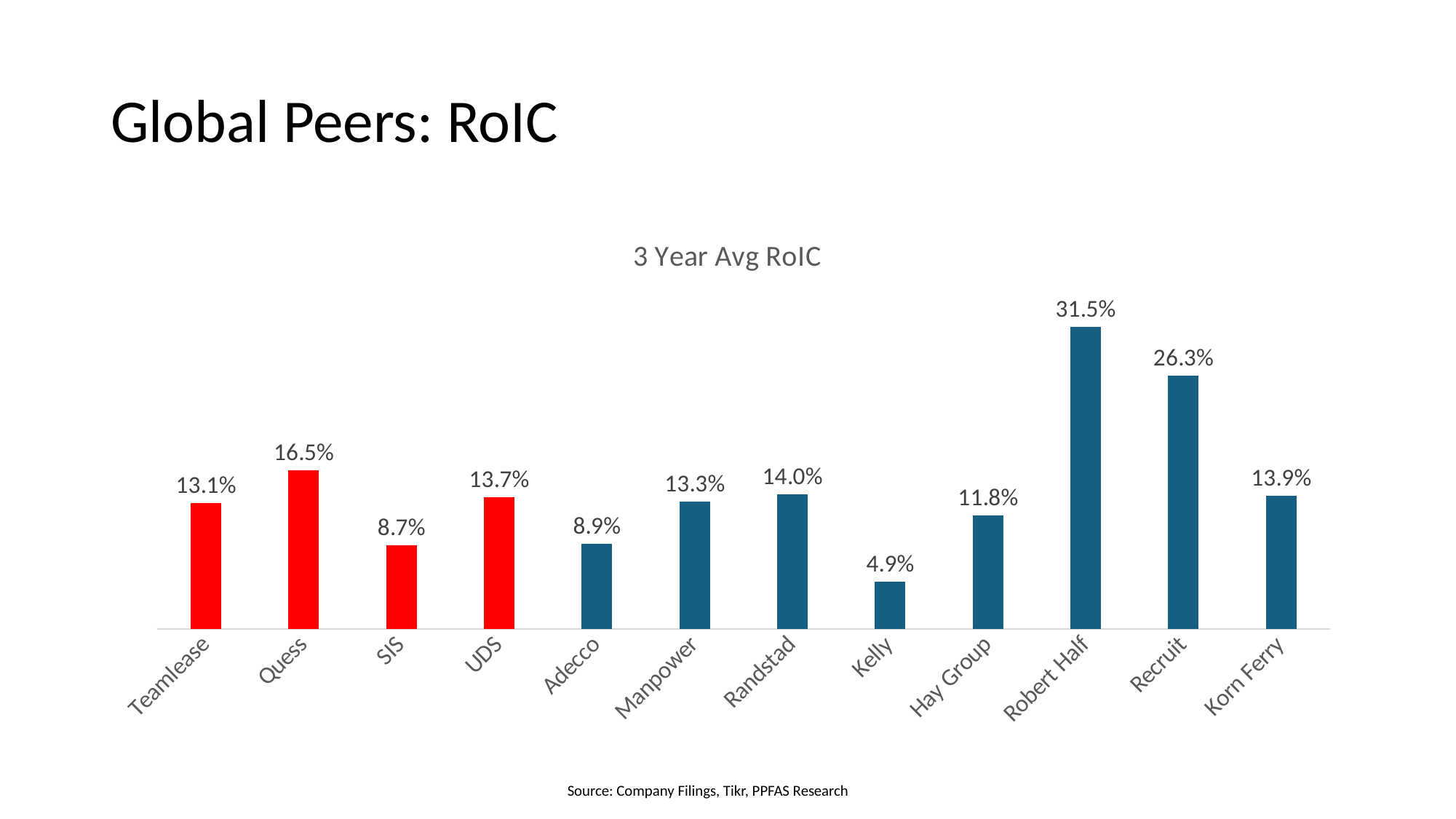
What is the title of the chart? 3 Year Avg RoIC Which company has the lowest 3 Year Avg RoIC? Kelly What is the 3 Year Avg RoIC for Quess? 16.5% How many companies are shown in the chart? 12 What is the difference in 3 Year Avg RoIC between Robert Half and Recruit? 5.2% Which has a higher 3 Year Avg RoIC, Randstad or Manpower? Randstad What is the 3 Year Avg RoIC for Kelly? 4.9% What kind of chart is shown on the slide? Bar chart Which company has the highest 3 Year Avg RoIC? Robert Half What is the difference in 3 Year Avg RoIC between Quess and Teamlease? 3.4% What is the 3 Year Avg RoIC for Korn Ferry? 13.9% What is the 3 Year Avg RoIC for Robert Half? 31.5%